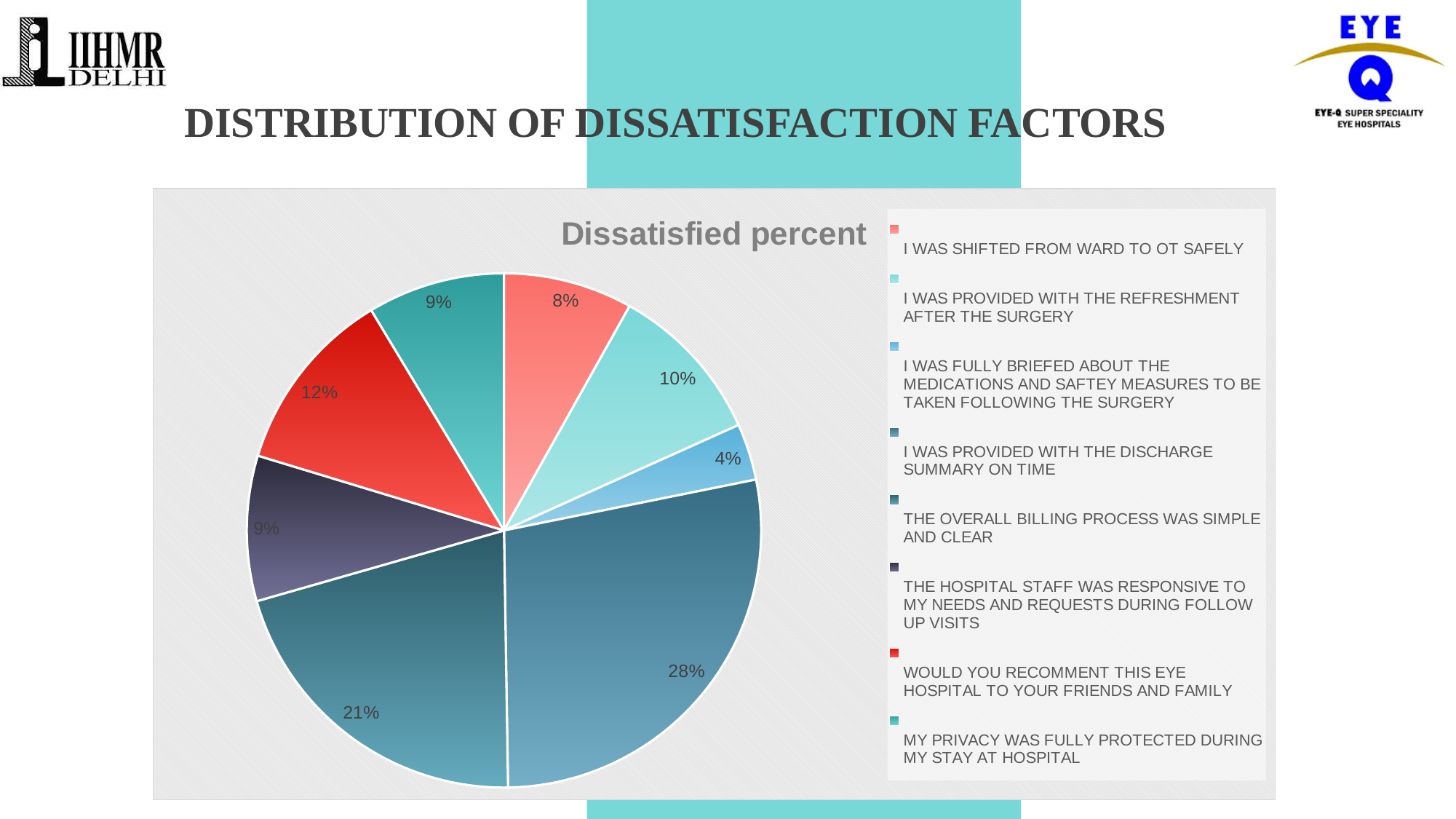
What percentage is shown for 'I WAS PROVIDED WITH THE DISCHARGE SUMMARY ON TIME'? 28% What percentage is shown for 'THE OVERALL BILLING PROCESS WAS SIMPLE AND CLEAR'? 21% What is the title of the chart? Dissatisfied percent How many categories does the legend list? 8 Which is larger: the share for 'I WAS PROVIDED WITH THE REFRESHMENT AFTER THE SURGERY' or the share for 'I WAS SHIFTED FROM WARD TO OT SAFELY'? I WAS PROVIDED WITH THE REFRESHMENT AFTER THE SURGERY What kind of chart is shown on the slide? Pie chart What percentage is shown for 'I WAS SHIFTED FROM WARD TO OT SAFELY'? 8% What percentage is shown for 'WOULD YOU RECOMMENT THIS EYE HOSPITAL TO YOUR FRIENDS AND FAMILY'? 12% What percentage is shown for 'I WAS FULLY BRIEFED ABOUT THE MEDICATIONS AND SAFTEY MEASURES TO BE TAKEN FOLLOWING THE SURGERY'? 4% Which category has the smallest share of the pie? I WAS FULLY BRIEFED ABOUT THE MEDICATIONS AND SAFTEY MEASURES TO BE TAKEN FOLLOWING THE SURGERY Which category has the largest share of the pie? I WAS PROVIDED WITH THE DISCHARGE SUMMARY ON TIME What is the difference in percentage points between the discharge summary slice (28%) and the billing process slice (21%)? 7